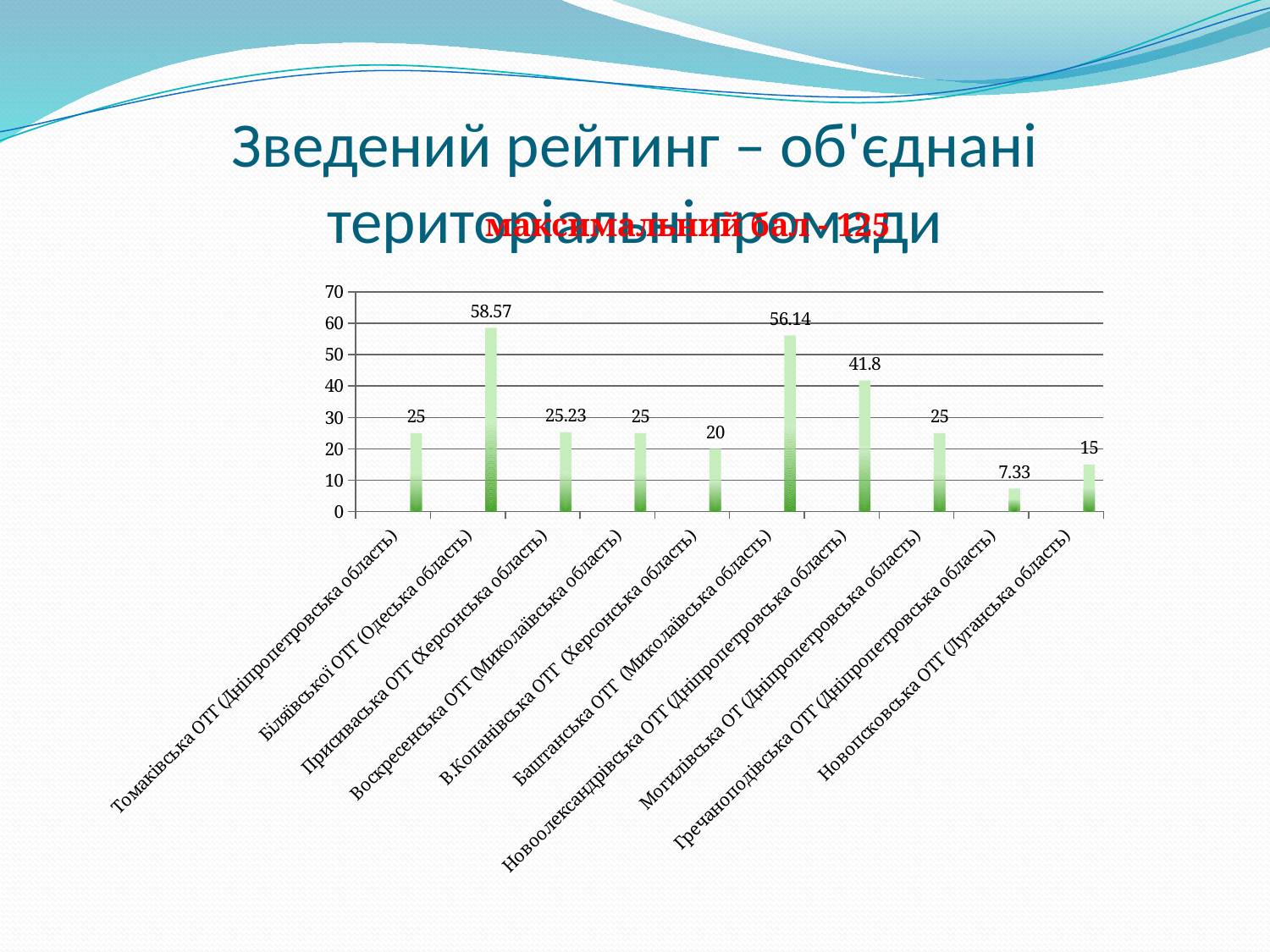
Which category has the highest value? Біляївської ОТГ (Одеська область) What maximum score is stated in red text on the slide? 125 What value is shown for Біляївської ОТГ (Одеська область)? 58.57 What is the difference between the values for Біляївської ОТГ (Одеська область) and Баштанська ОТГ (Миколаївська область)? 2.43 How many categories are shown on the chart? 10 Is the value for Новоолександрівська ОТГ (Дніпропетровська область) greater or less than 40? greater Which category has the lowest value? Гречаноподівська ОТГ (Дніпропетровська область) What value is shown for Гречаноподівська ОТГ (Дніпропетровська область)? 7.33 What value is shown for Баштанська ОТГ (Миколаївська область)? 56.14 Which is larger: the value for Новопсковська ОТГ (Луганська область) or the value for В.Копанівська ОТГ (Херсонська область)? В.Копанівська ОТГ (Херсонська область) What value is shown for Новоолександрівська ОТГ (Дніпропетровська область)? 41.8 What kind of chart is shown on the slide? bar chart